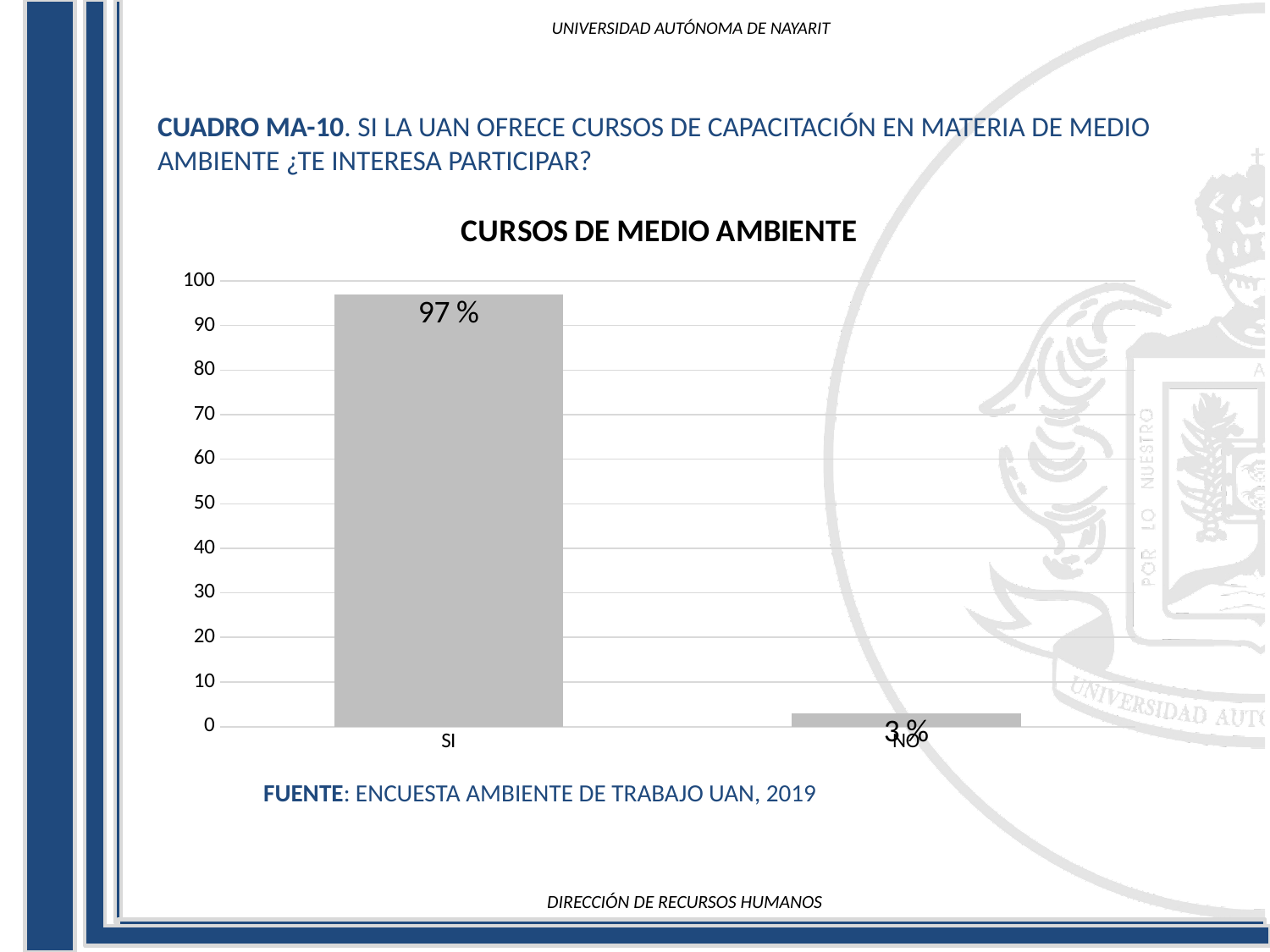
What is the title of the chart? CURSOS DE MEDIO AMBIENTE Which category has the highest value? SI Which category has the lowest value? NO Is the value for SI greater or less than 90? greater What is the maximum value shown on the vertical axis? 100 What is the value for NO in the chart? 3 % How many categories are shown in the chart? 2 Is the value for NO greater or less than 10? less What is the value for SI in the chart? 97 % What is the difference between the values for SI and NO? 94 % Which is larger, the value for SI or the value for NO? SI What kind of chart is shown on the slide? bar chart